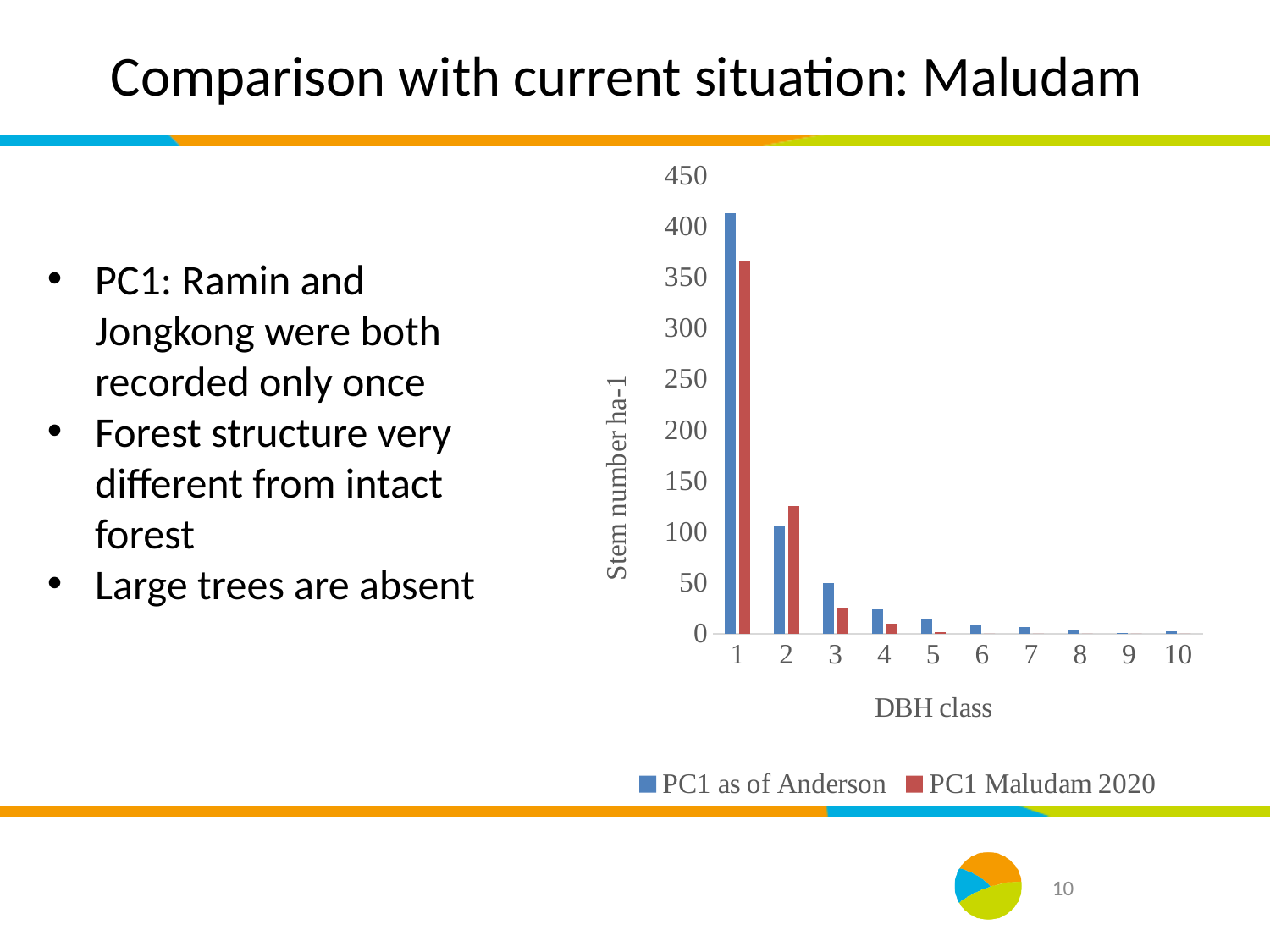
What kind of chart is shown on the slide? bar chart How many series does the legend list? 2 At DBH class 2, which series has the larger value, PC1 as of Anderson or PC1 Maludam 2020? PC1 Maludam 2020 Do the values for PC1 as of Anderson rise or fall as the DBH class increases? fall How many DBH classes are shown on the x axis? 10 Is the value for PC1 Maludam 2020 at DBH class 3 greater or less than 50? less Is the value for PC1 Maludam 2020 at DBH class 1 greater or less than 400? less Is the value for PC1 as of Anderson at DBH class 1 greater or less than 400? greater Which DBH class has the highest value for PC1 as of Anderson? 1 At DBH class 1, which series has the larger value, PC1 as of Anderson or PC1 Maludam 2020? PC1 as of Anderson What is the title of the vertical axis? Stem number ha-1